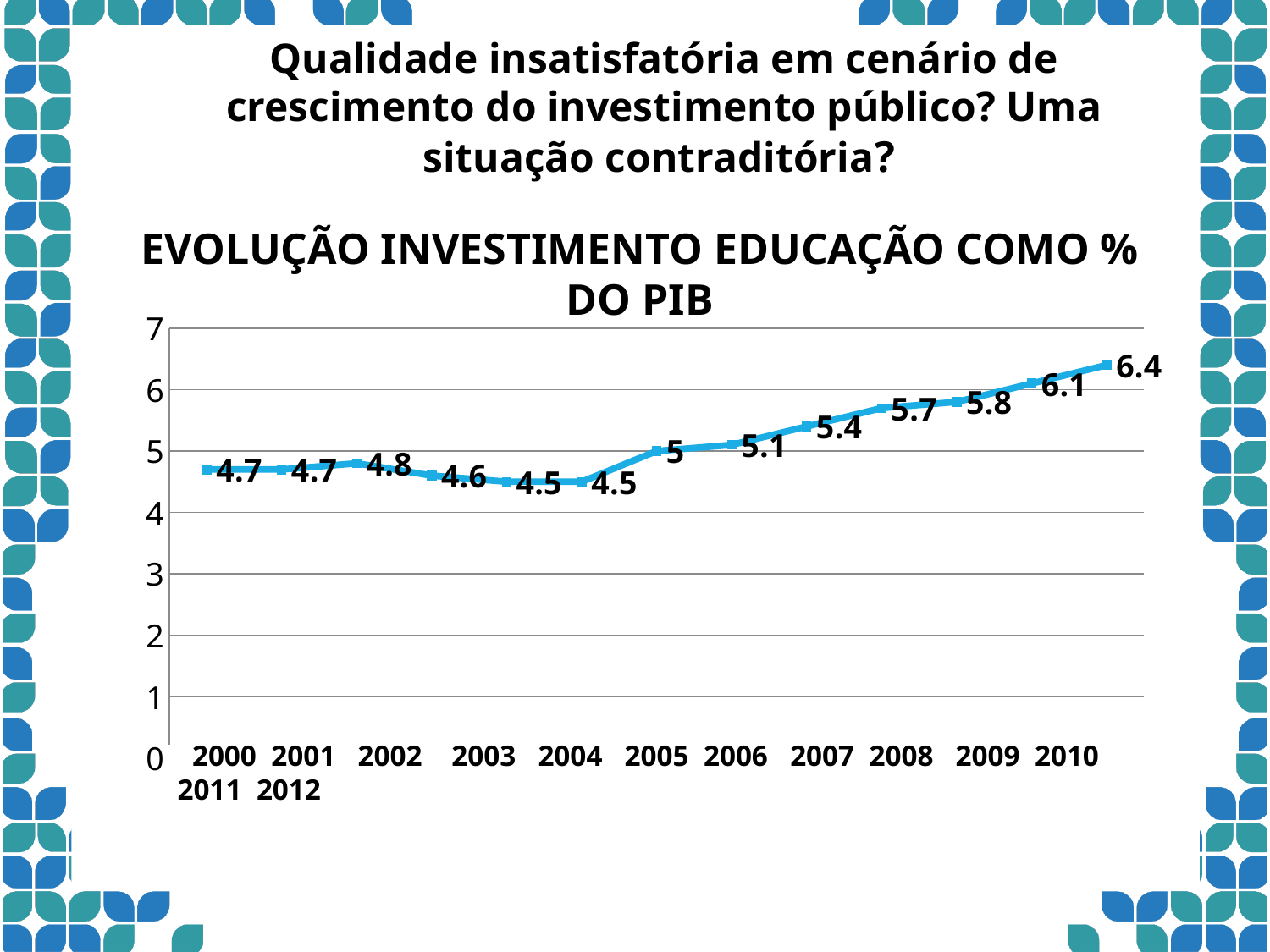
What is the highest value shown on the vertical axis? 7 What is the highest value shown on the line? 6.4 What is the lowest value shown on the line? 4.5 Which is larger, the value of the first data point or the value of the last data point? the last data point What is the value of the first data point (2000)? 4.7 Overall, do the values rise or fall from the first year to the last year? rise How many data points are plotted on the line? 13 What is the difference between the last data point (6.4) and the first data point (4.7)? 1.7 What is the title of the chart? EVOLUÇÃO INVESTIMENTO EDUCAÇÃO COMO % DO PIB What is the value of the last data point (2012)? 6.4 What kind of chart is shown on the slide? line chart Is the value of the last data point greater or less than 6? greater